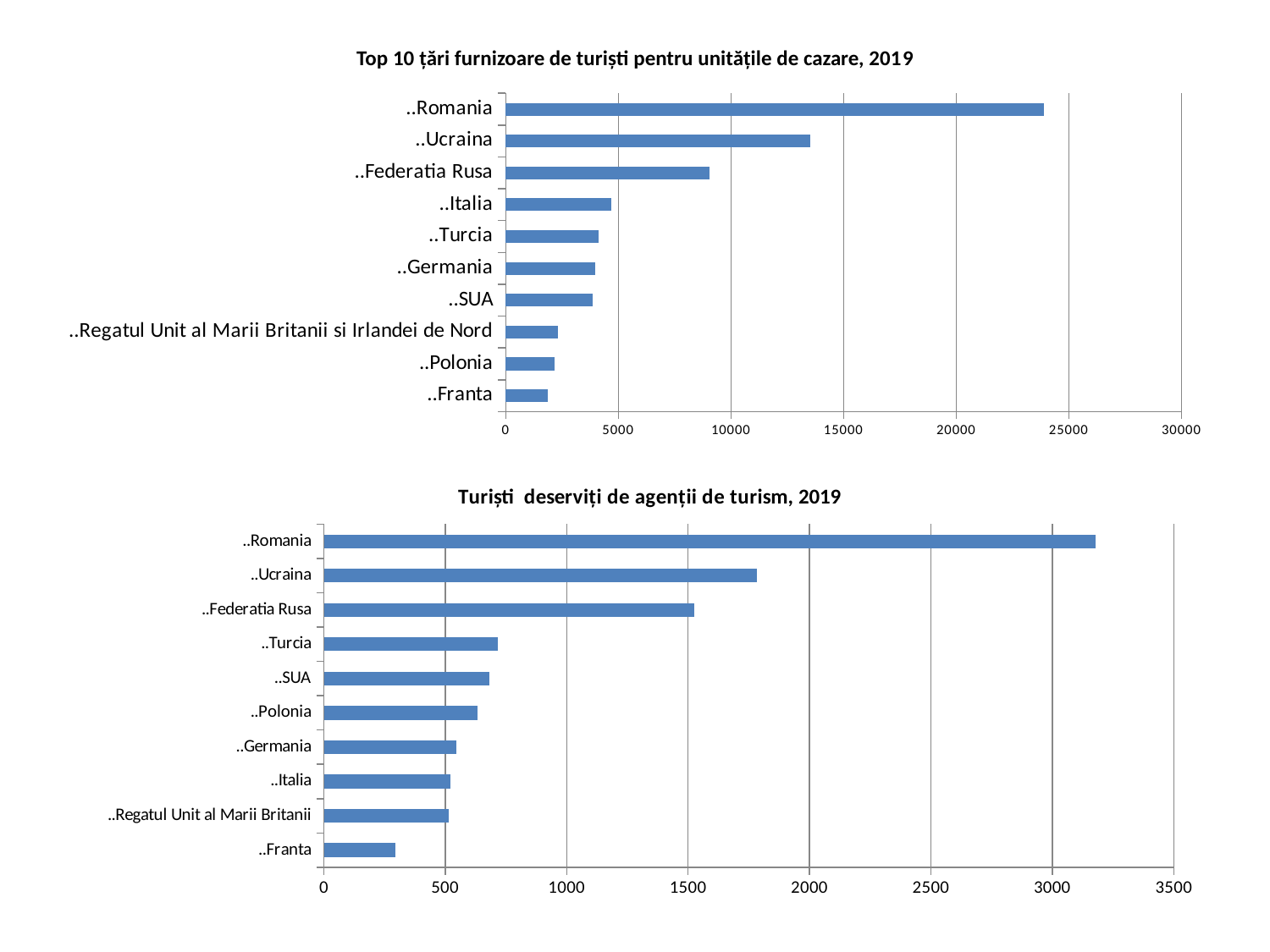
In the top chart, is the value for Ucraina greater or less than 10000? greater What kind of chart is the bottom chart? bar chart In the chart titled "Turiști deserviți de agenții de turism, 2019", which country has the lowest value? Franta In the chart titled "Top 10 țări furnizoare de turiști pentru unitățile de cazare, 2019", which country has the lowest value? Franta In the bottom chart, is the value for Romania greater or less than 3000? greater In the top chart, is the value for Romania greater or less than 20000? greater In the chart titled "Turiști deserviți de agenții de turism, 2019", which country has the highest value? Romania In the top chart, which has the larger value, Ucraina or Federatia Rusa? Ucraina In the chart titled "Top 10 țări furnizoare de turiști pentru unitățile de cazare, 2019", which country has the highest value? Romania How many countries are shown in the top chart? 10